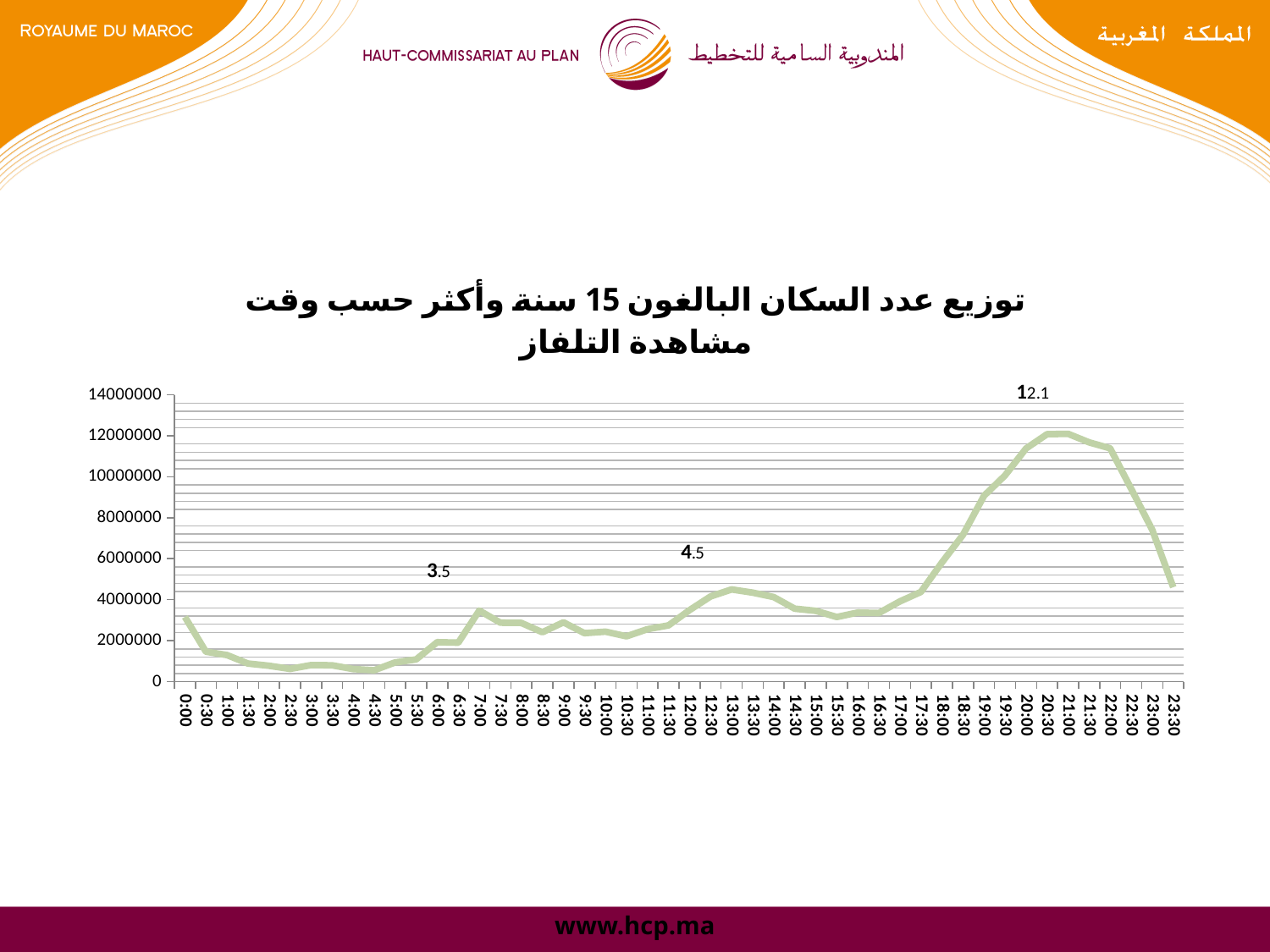
How many time points are labelled along the x axis of the chart? 48 Which has the larger value, 21:00 or 13:00? 21:00 Is the value at 10:30 greater or less than 4000000? less Is the value at 21:00 greater or less than 10000000? greater Is the value at 3:00 greater or less than 2000000? less Do the values rise or fall between 21:00 and 23:30? fall Do the values rise or fall between 17:00 and 21:00? rise What is the highest tick value shown on the y axis? 14000000 What kind of chart is shown on the slide? line chart Which has the larger value, 7:00 or 3:00? 7:00